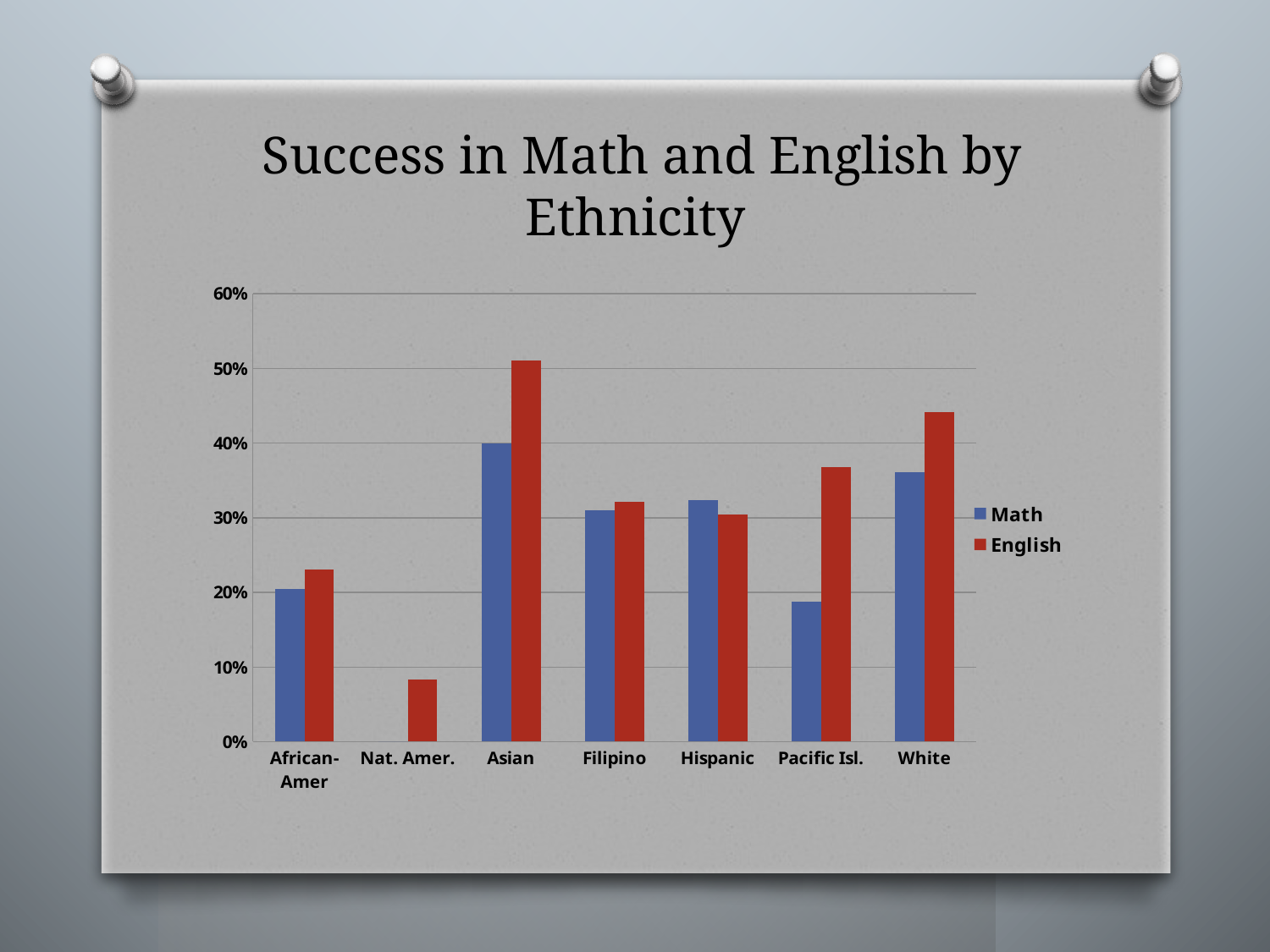
Is the Math value for African-Amer greater or less than 30%? less Is the English value for Nat. Amer. greater or less than 10%? less How many series does the legend list? 2 How many ethnicity categories are shown on the x axis? 7 Which ethnicity has the highest English value? Asian What type of chart is shown on the slide? Bar chart For Pacific Isl., which is larger, the Math value or the English value? English Is the English value for White greater or less than 40%? greater Which is larger, the Math value for Asian or the Math value for White? Asian Which ethnicity has the lowest English value? Nat. Amer. What are the two series named in the legend? Math and English Which ethnicity has the highest Math value? Asian